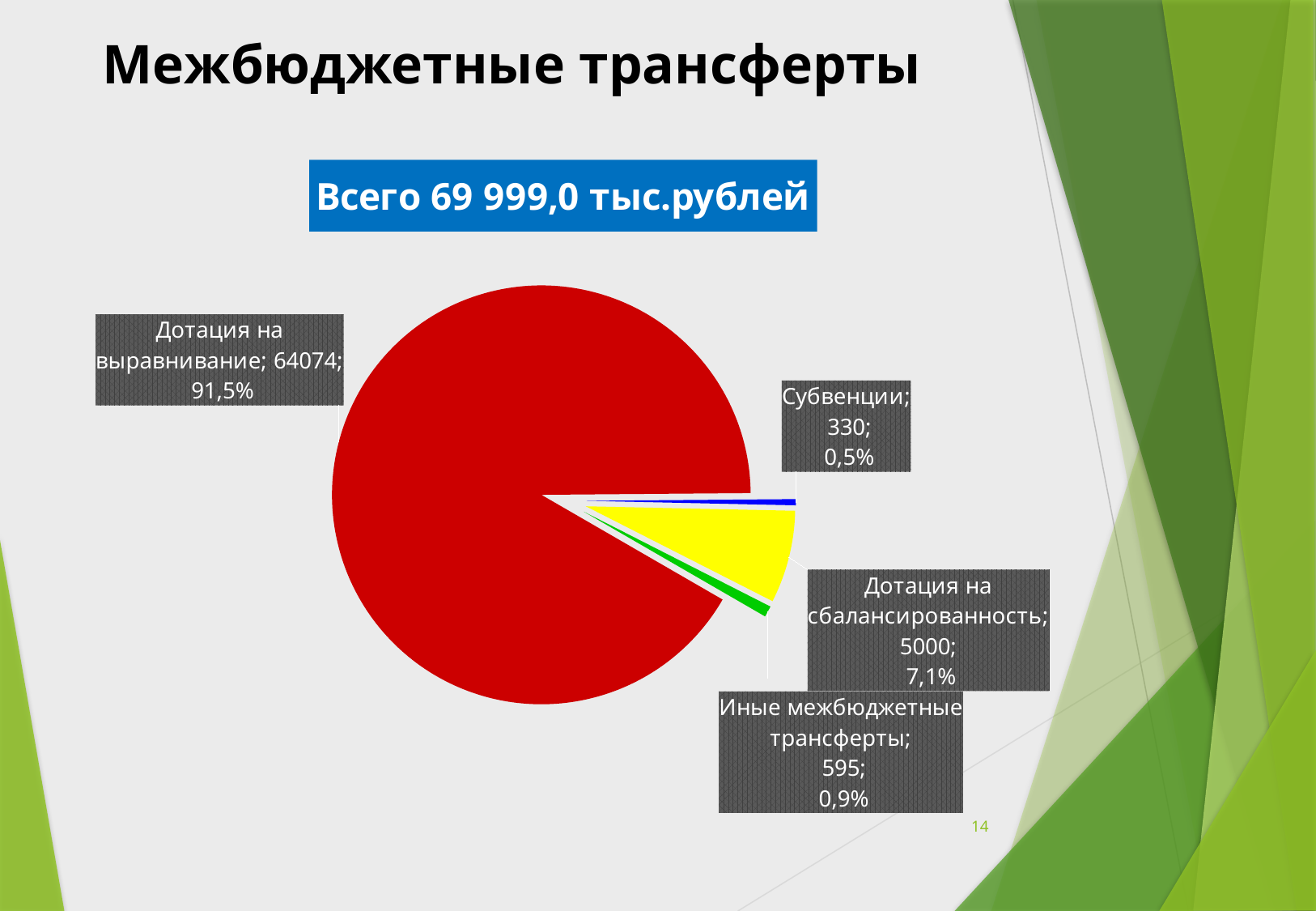
Which category has the smallest slice? Субвенции What is the value for Иные межбюджетные трансферты? 595 What is the value for Дотация на сбалансированность? 5000 What share of the pie does Дотация на выравнивание represent? 91,5% What is the value for Субвенции? 330 How many slices does the pie chart have? 4 What kind of chart is shown on the slide? pie chart What is the difference between the values for Дотация на сбалансированность and Иные межбюджетные трансферты? 4405 Which category has the largest slice? Дотация на выравнивание What is the value for Дотация на выравнивание? 64074 What share of the pie does Дотация на сбалансированность represent? 7,1% Which is larger, Иные межбюджетные трансферты or Субвенции? Иные межбюджетные трансферты